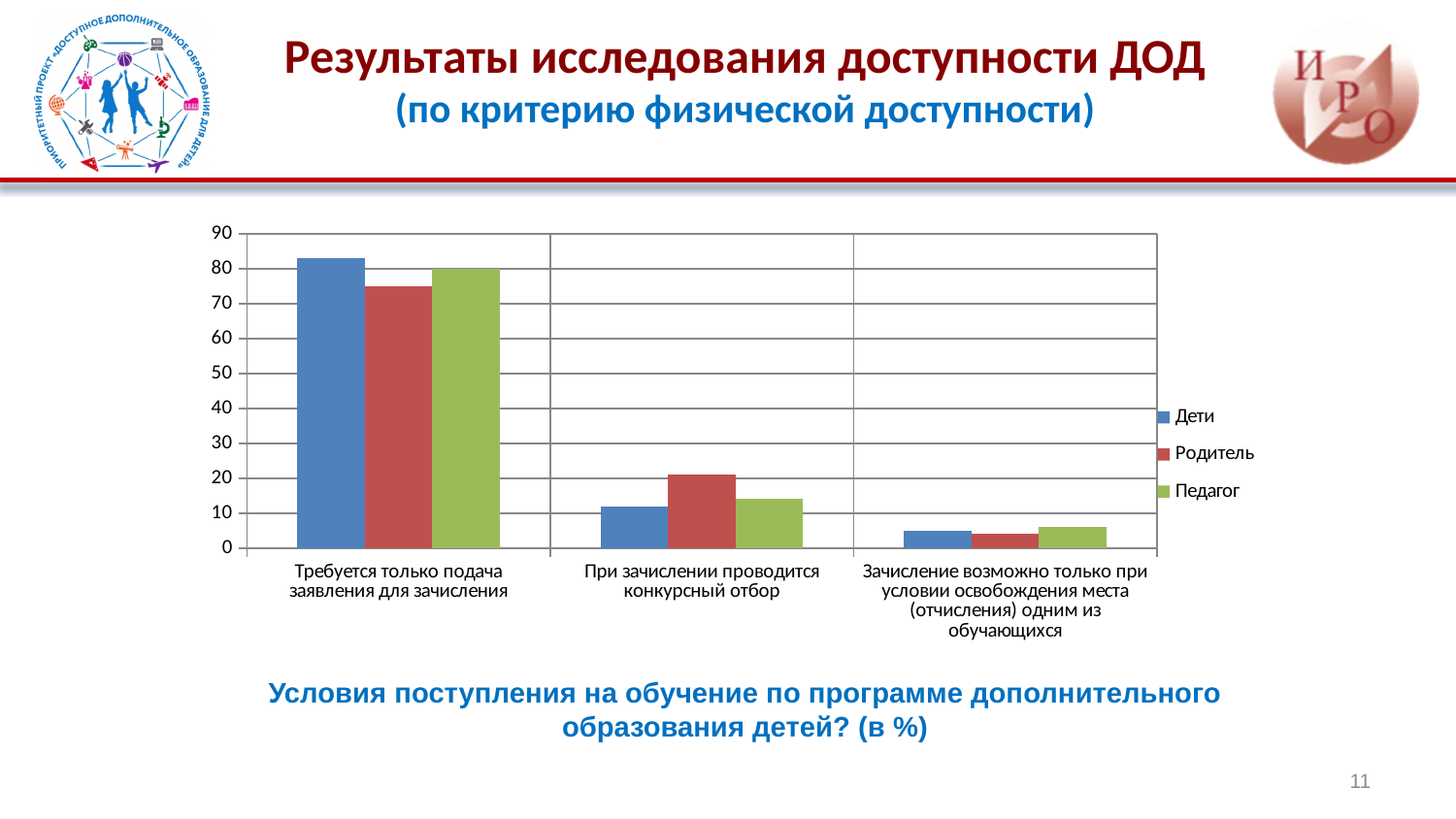
What kind of chart is shown on the slide? bar chart Is the value for Дети in the category 'При зачислении проводится конкурсный отбор' greater or less than 20? less Which colour represents the series Педагог? green Is the value for Дети in the category 'Требуется только подача заявления для зачисления' greater or less than 80? greater For the series Дети, which is larger: the value for 'Требуется только подача заявления для зачисления' or for 'Зачисление возможно только при условии освобождения места (отчисления) одним из обучающихся'? Требуется только подача заявления для зачисления Which series does the legend list first? Дети How many series does the legend list? 3 Is the value for Родитель in the category 'Требуется только подача заявления для зачисления' greater or less than 80? less Which series has the lowest value in the category 'Требуется только подача заявления для зачисления'? Родитель How many categories are shown on the x axis? 3 Which series has the highest value in the category 'При зачислении проводится конкурсный отбор'? Родитель